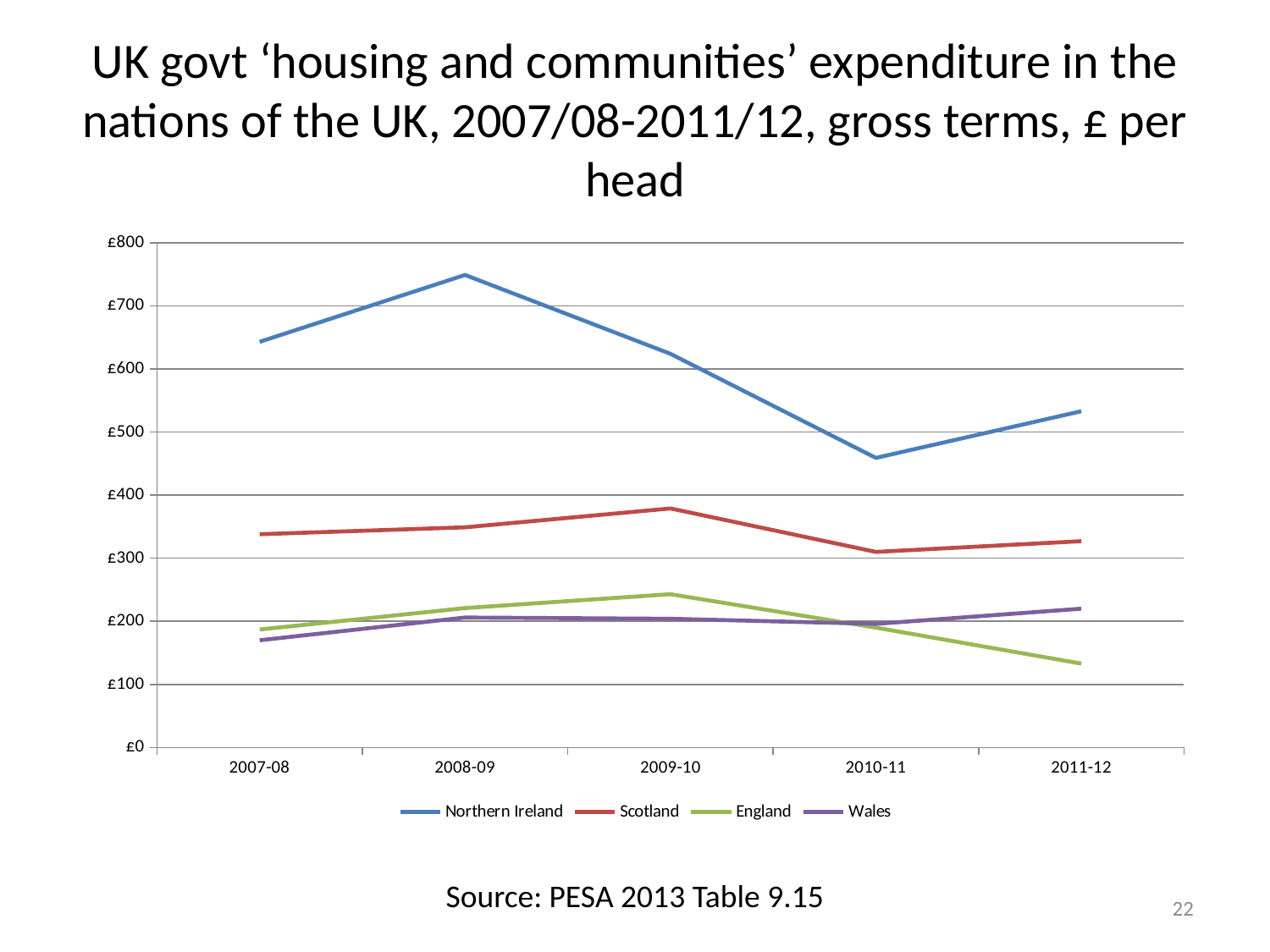
Is the value for Scotland in 2009-10 greater or less than £400? less In which year does the Northern Ireland line reach its highest point? 2008-09 In 2011-12, which is larger, the value for England or the value for Wales? Wales How many series does the legend list? 4 Is the value for Northern Ireland in 2010-11 greater or less than £500? less In which year does the Northern Ireland line reach its lowest point? 2010-11 Which nation has the lowest expenditure per head in 2011-12? England How many financial years are plotted along the x axis? 5 Which nation has the highest expenditure per head in every year shown? Northern Ireland What kind of chart is shown on the slide? line chart Is the value for Northern Ireland in 2008-09 greater or less than £700? greater Does the England line rise or fall from 2009-10 to 2011-12? fall